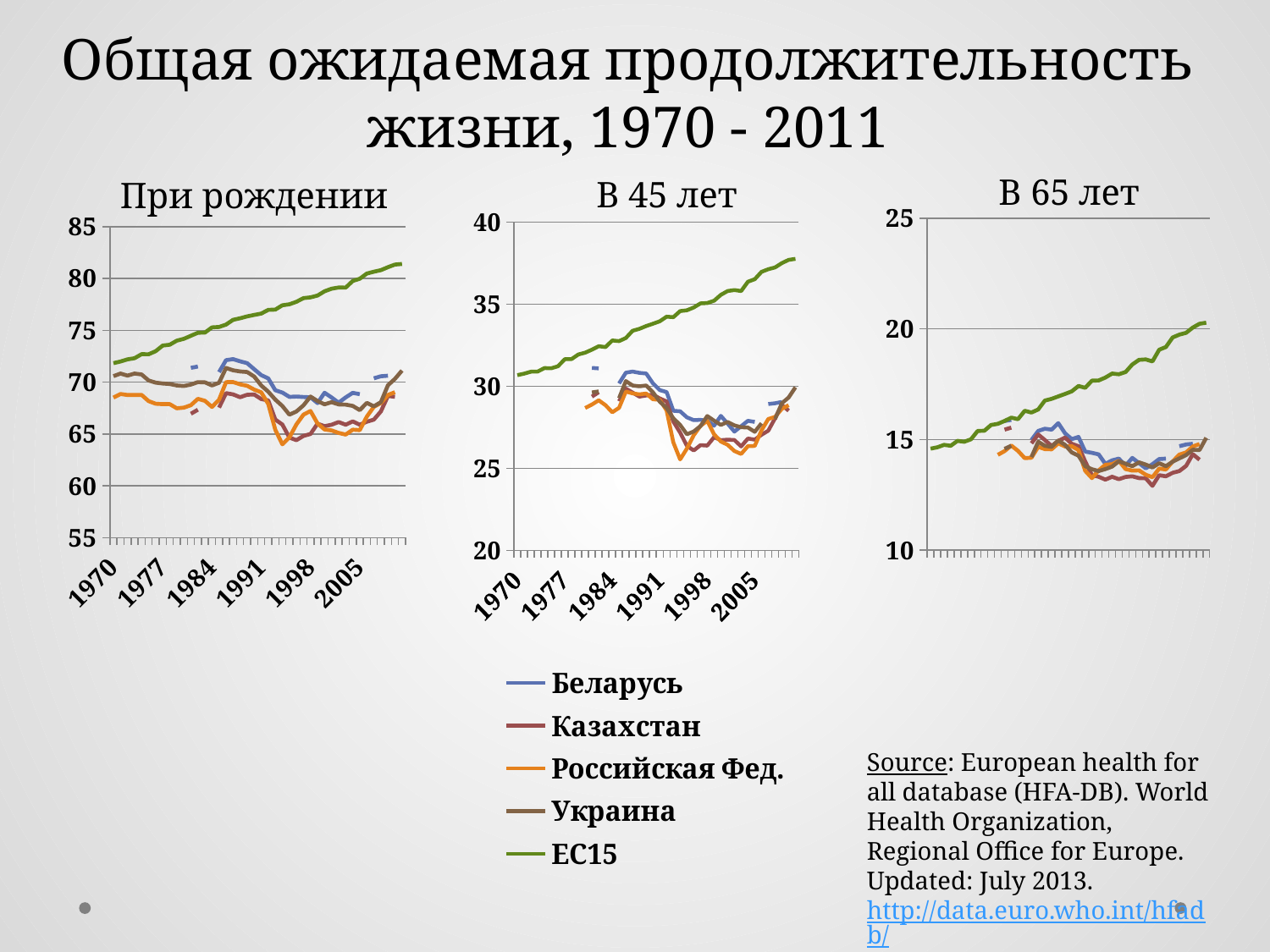
What kind of chart is the "При рождении" chart? line chart How many series does the legend list? 5 In the "При рождении" chart, is the value for ЕС15 in 2005 greater or less than 75? greater In the "При рождении" chart, is the value for Российская Фед. in 1970 greater or less than 70? less In the "В 65 лет" chart, does the ЕС15 line rise or fall from 1970 to 2011? rises In the "При рождении" chart, which series has the highest values across the whole period? ЕС15 How many year labels are shown on the x axis of the "При рождении" chart? 6 What is the title of the leftmost chart? При рождении In the "В 45 лет" chart, which series is lowest around 1994? Российская Фед. In the "В 65 лет" chart, is the value for ЕС15 at the end of the period greater or less than 15? greater In the "При рождении" chart, which is higher in 1970: ЕС15 or Российская Фед.? ЕС15